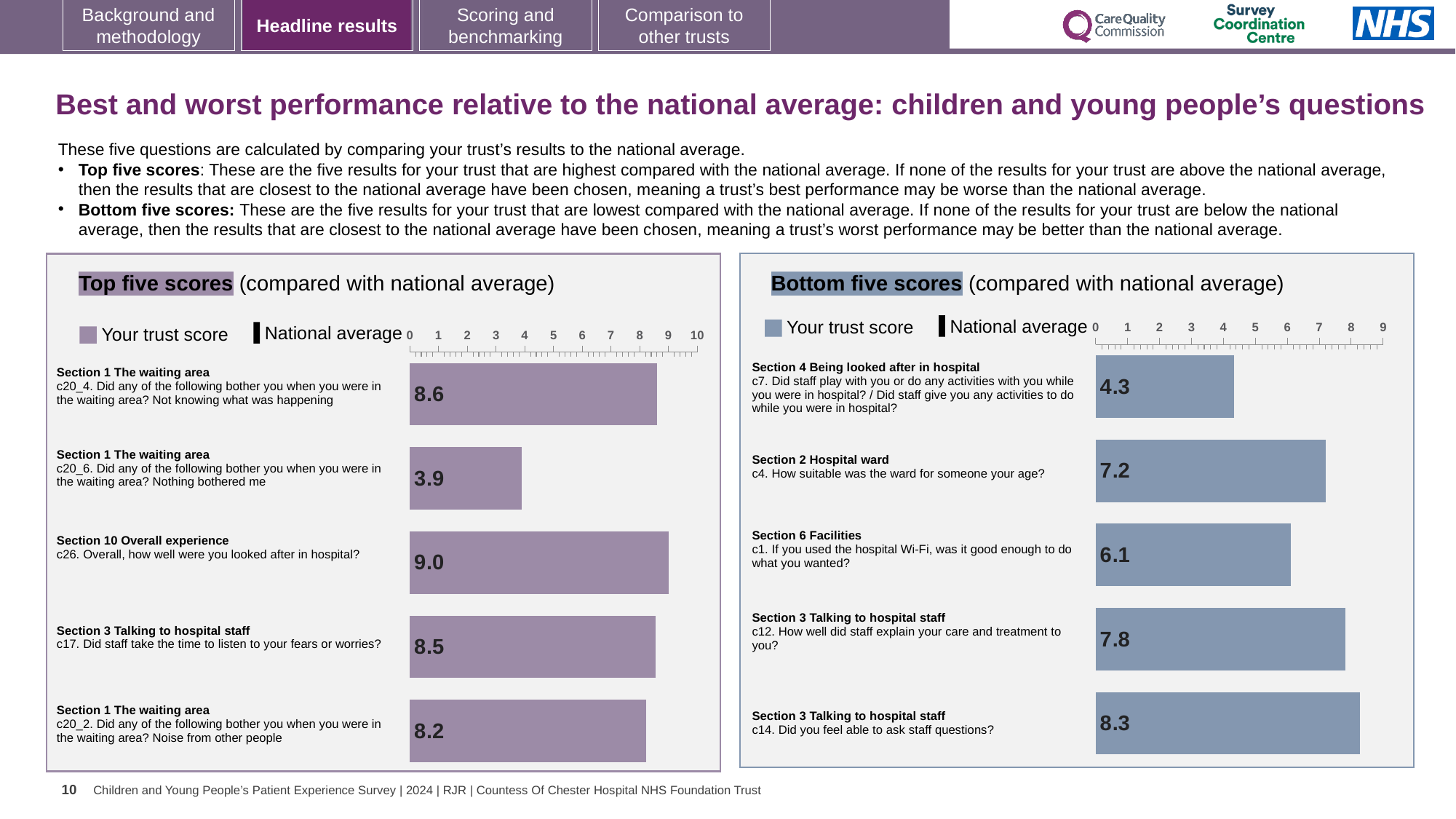
How many questions are shown in the 'Top five scores' chart? 5 In the 'Bottom five scores' chart, is the trust score for c12 'How well did staff explain your care and treatment to you?' greater or less than 7? greater In the 'Bottom five scores' chart, what is the trust score for c7 'Did staff play with you or do any activities with you while you were in hospital?' 4.3 How many series does the legend of the 'Top five scores' chart list? 2 What type of chart is the 'Bottom five scores' chart? Bar chart In the 'Bottom five scores' chart, which question has the lowest trust score? c7. Did staff play with you or do any activities with you while you were in hospital? In the 'Top five scores' chart, what is the difference between the trust scores for c20_4 'Not knowing what was happening' and c20_2 'Noise from other people'? 0.4 In the 'Bottom five scores' chart, what is the trust score for c14 'Did you feel able to ask staff questions?' 8.3 In the 'Top five scores' chart, which question has the highest trust score? c26. Overall, how well were you looked after in hospital? In the 'Top five scores' chart, what is the trust score for c20_6 'Nothing bothered me'? 3.9 In the 'Bottom five scores' chart, which has the larger trust score: c4 'How suitable was the ward for someone your age?' or c1 'If you used the hospital Wi-Fi, was it good enough to do what you wanted?' c4. How suitable was the ward for someone your age? In the 'Top five scores' chart, what is the trust score for c26 'Overall, how well were you looked after in hospital?' 9.0